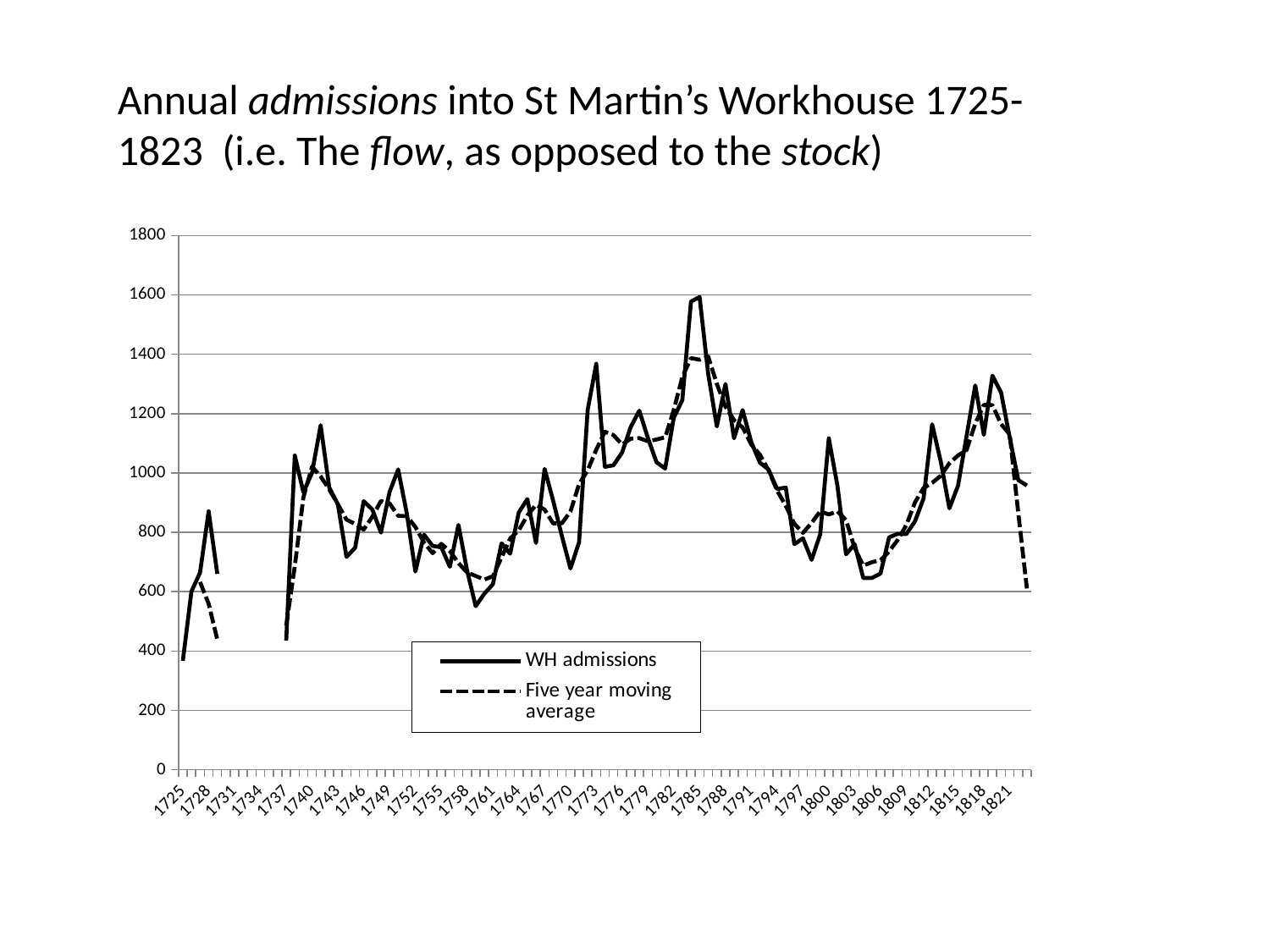
Is the value of WH admissions in 1806 greater or less than 800? less What kind of chart is shown on the slide? line chart Does the five year moving average generally rise or fall between 1806 and 1818? rise What is the highest value shown on the vertical axis? 1800 Which series reaches the higher value at its peak around 1785, WH admissions or the five year moving average? WH admissions Which series is drawn with a dashed line? Five year moving average Is the peak value of WH admissions around 1785 greater or less than 1400? greater Is the value of WH admissions in 1725 greater or less than 400? less How many series does the legend list? 2 Does the five year moving average generally rise or fall between 1785 and 1806? fall